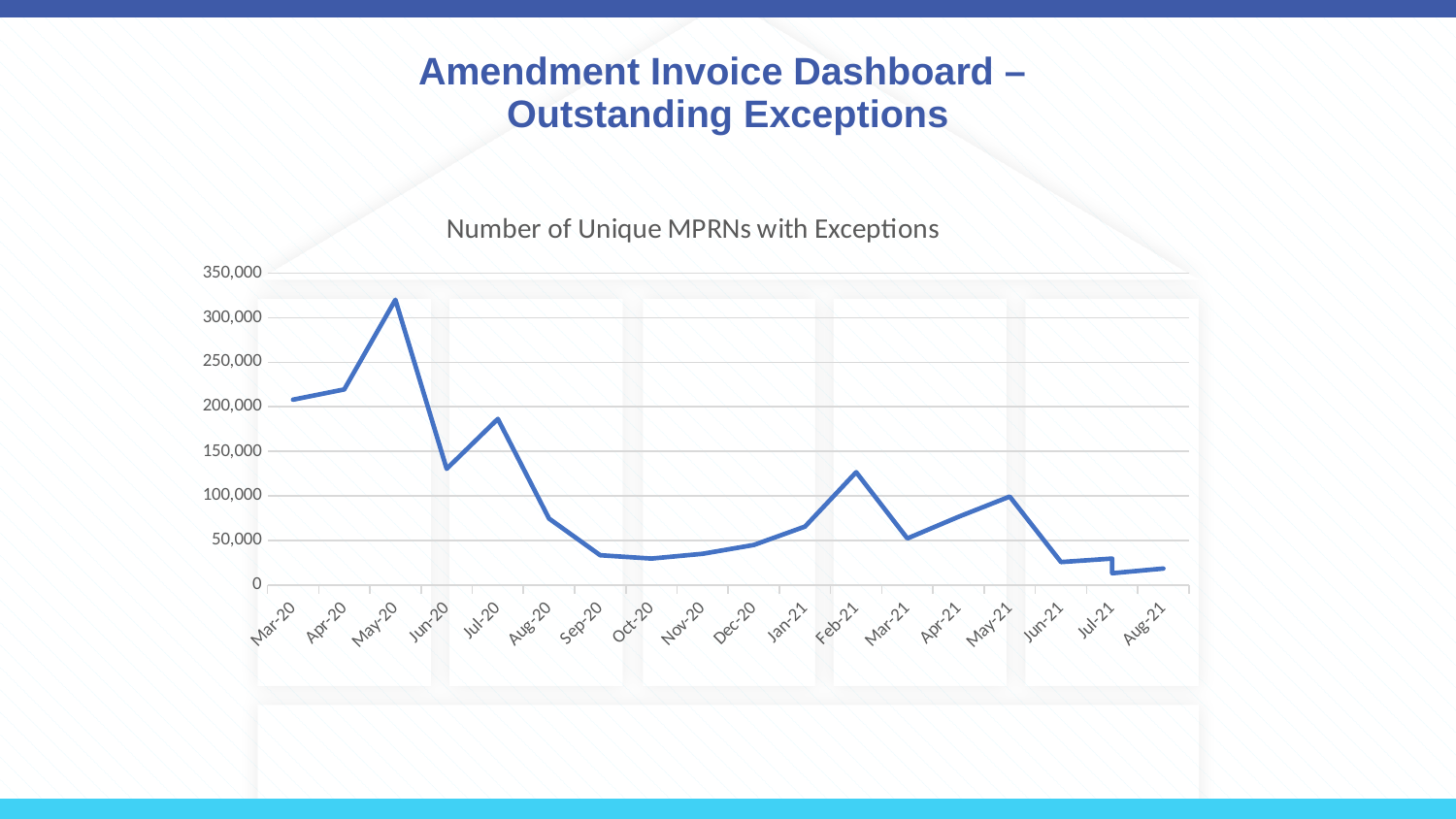
Is the value for Sep-20 greater or less than 50,000? less Which is larger, the value for Feb-21 or the value for May-21? Feb-21 How many months are plotted on the x axis of the chart? 18 Is the value for Jun-20 greater or less than 150,000? less Is the value for Jun-21 greater or less than 50,000? less Do the values rise or fall from May-20 to Sep-20? fall Which month has the highest number of unique MPRNs with exceptions? May-20 What kind of chart is shown on the slide? line chart What is the title of the chart? Number of Unique MPRNs with Exceptions